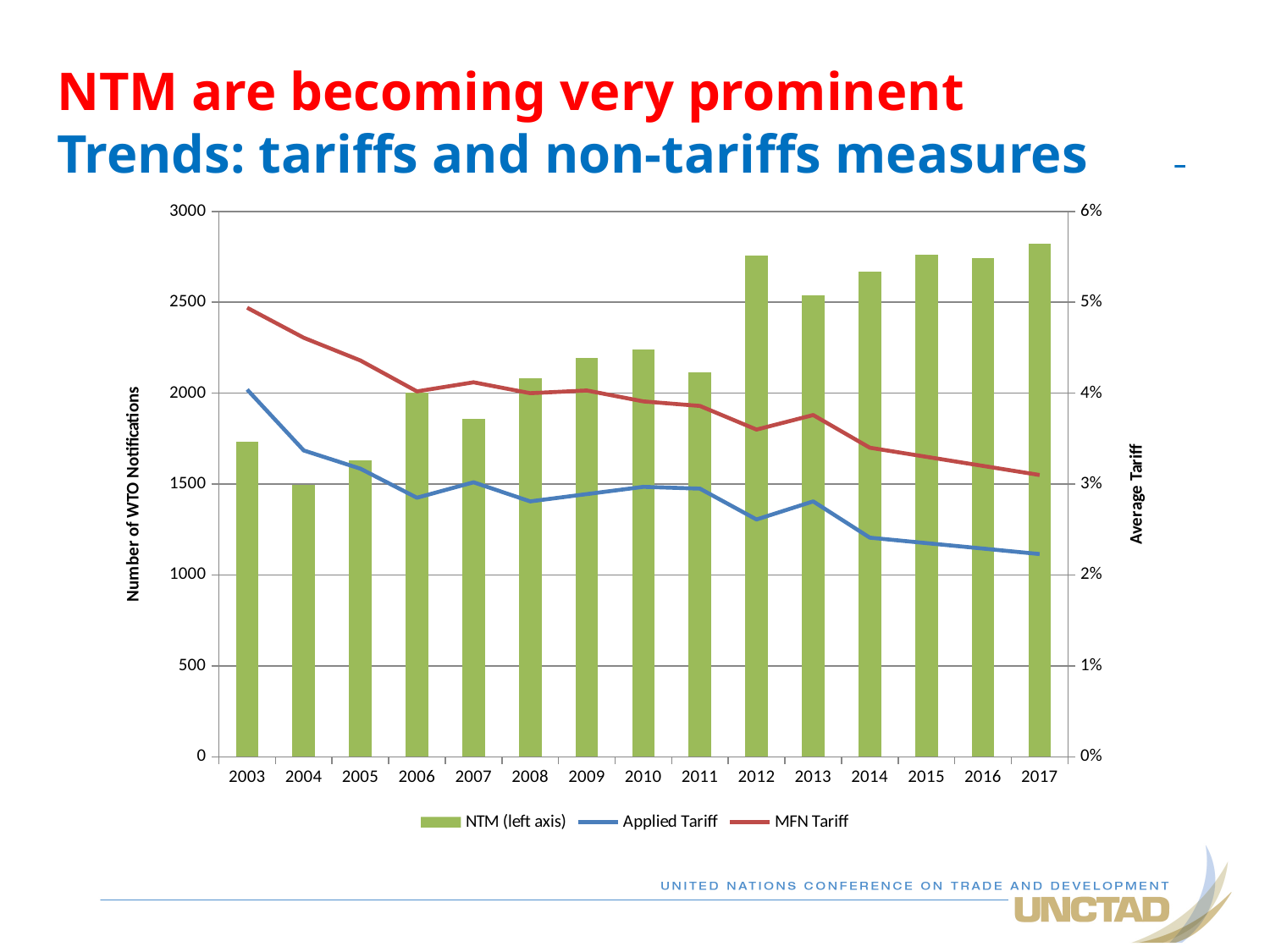
Which year has the highest number of NTM notifications? 2017 What is the title of the left vertical axis? Number of WTO Notifications What kind of chart is shown on the slide? A combined bar and line chart Is the MFN Tariff for 2003 greater or less than 4%? greater Does the MFN Tariff line generally rise or fall from 2003 to 2017? fall Which year has the lowest number of NTM notifications? 2004 Is the NTM value for 2004 greater or less than 2000? less How many years are shown on the x axis? 15 Is the Applied Tariff for 2017 greater or less than 3%? less How many series does the legend list? 3 Which year has more NTM notifications, 2012 or 2013? 2012